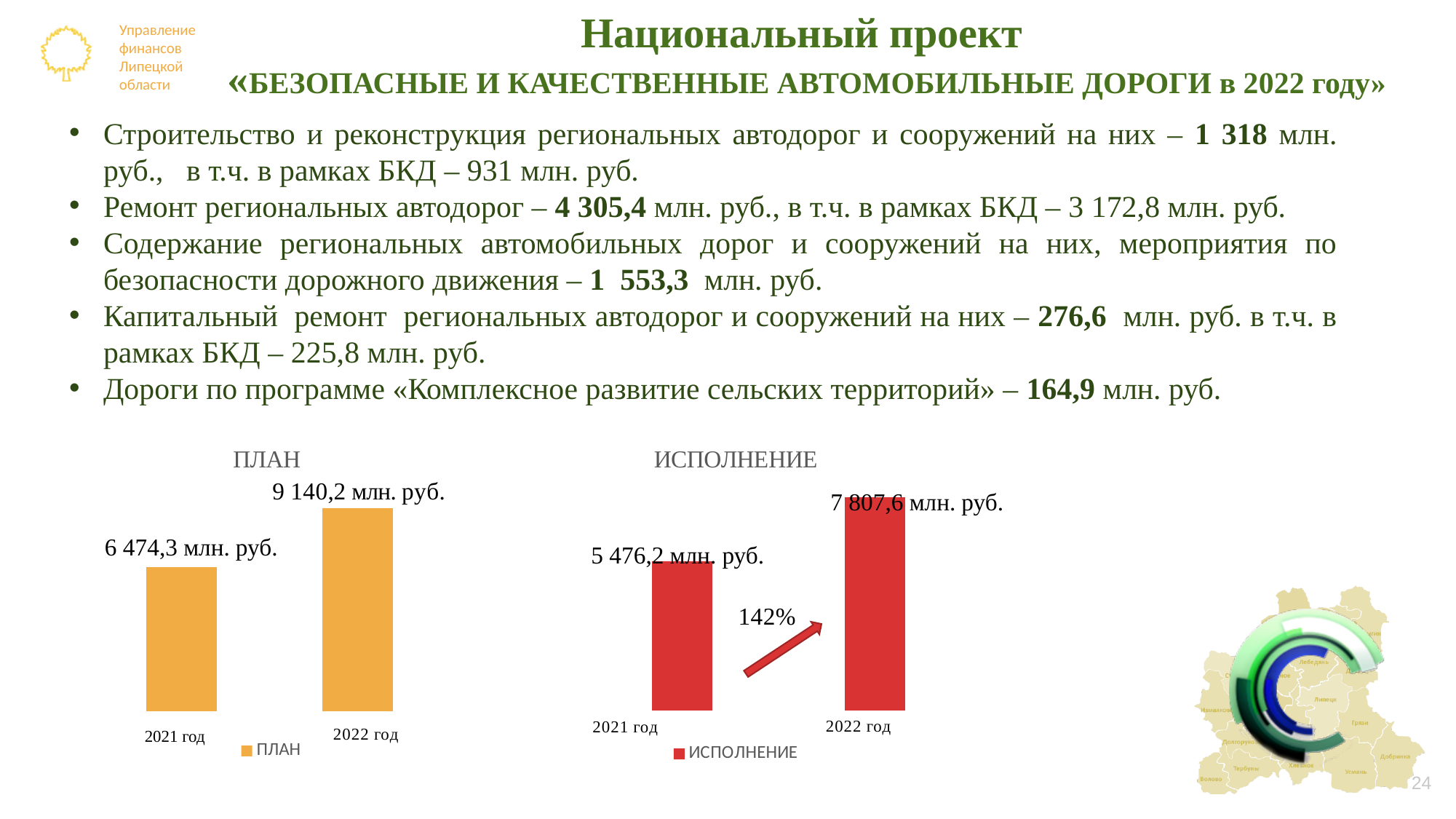
What percentage is shown next to the arrow in the ИСПОЛНЕНИЕ chart? 142% In the ИСПОЛНЕНИЕ chart, which year has the lower value? 2021 год Which is larger: the ПЛАН value for 2021 год or the ИСПОЛНЕНИЕ value for 2021 год? ПЛАН value for 2021 год In the ПЛАН chart, what is the value for 2021 год? 6 474,3 млн. руб. In the ПЛАН chart, by how much does the 2022 год value exceed the 2021 год value? 2 665,9 млн. руб. What type of chart is the ПЛАН chart? Bar chart In the ПЛАН chart, which year has the higher value? 2022 год In the ИСПОЛНЕНИЕ chart, what is the value for 2021 год? 5 476,2 млн. руб. In the ИСПОЛНЕНИЕ chart, what is the value for 2022 год? 7 807,6 млн. руб. How many bars does the ИСПОЛНЕНИЕ chart show? 2 In the ИСПОЛНЕНИЕ chart, what is the difference between the 2022 год and 2021 год values? 2 331,4 млн. руб. In the ПЛАН chart, what is the value for 2022 год? 9 140,2 млн. руб.